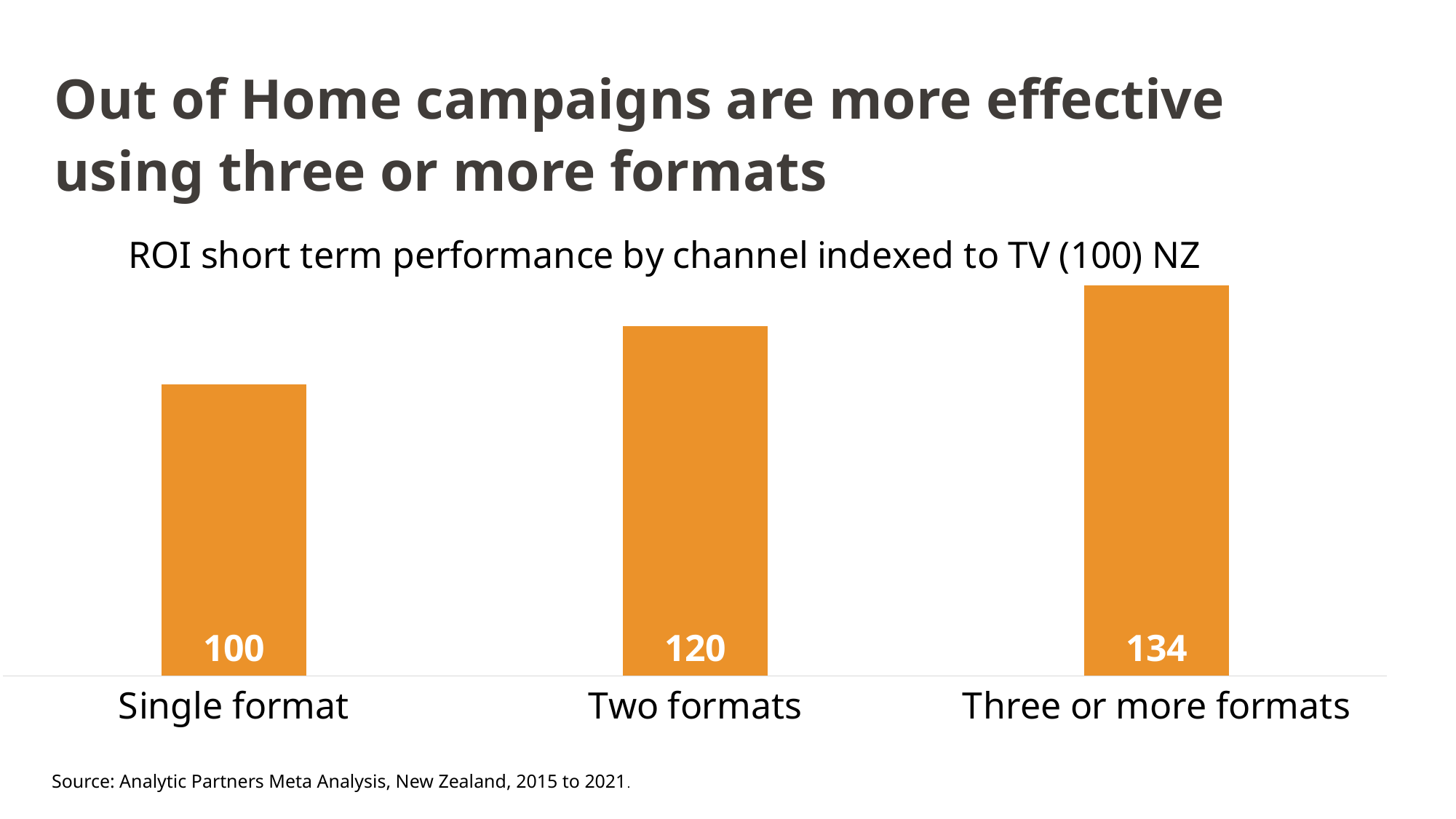
Which category has the highest value? Three or more formats What is the value for Three or more formats? 134 Do the values rise or fall from Single format to Three or more formats? Rise What is the difference between the values for Two formats and Single format? 20 Which category has the lowest value? Single format What kind of chart is shown on the slide? Bar chart What is the difference between the values for Three or more formats and Single format? 34 Which is larger, the value for Two formats or the value for Three or more formats? Three or more formats What is the value for Two formats? 120 How many categories are shown in the chart? 3 What is the title of the chart? ROI short term performance by channel indexed to TV (100) NZ What is the value for Single format? 100